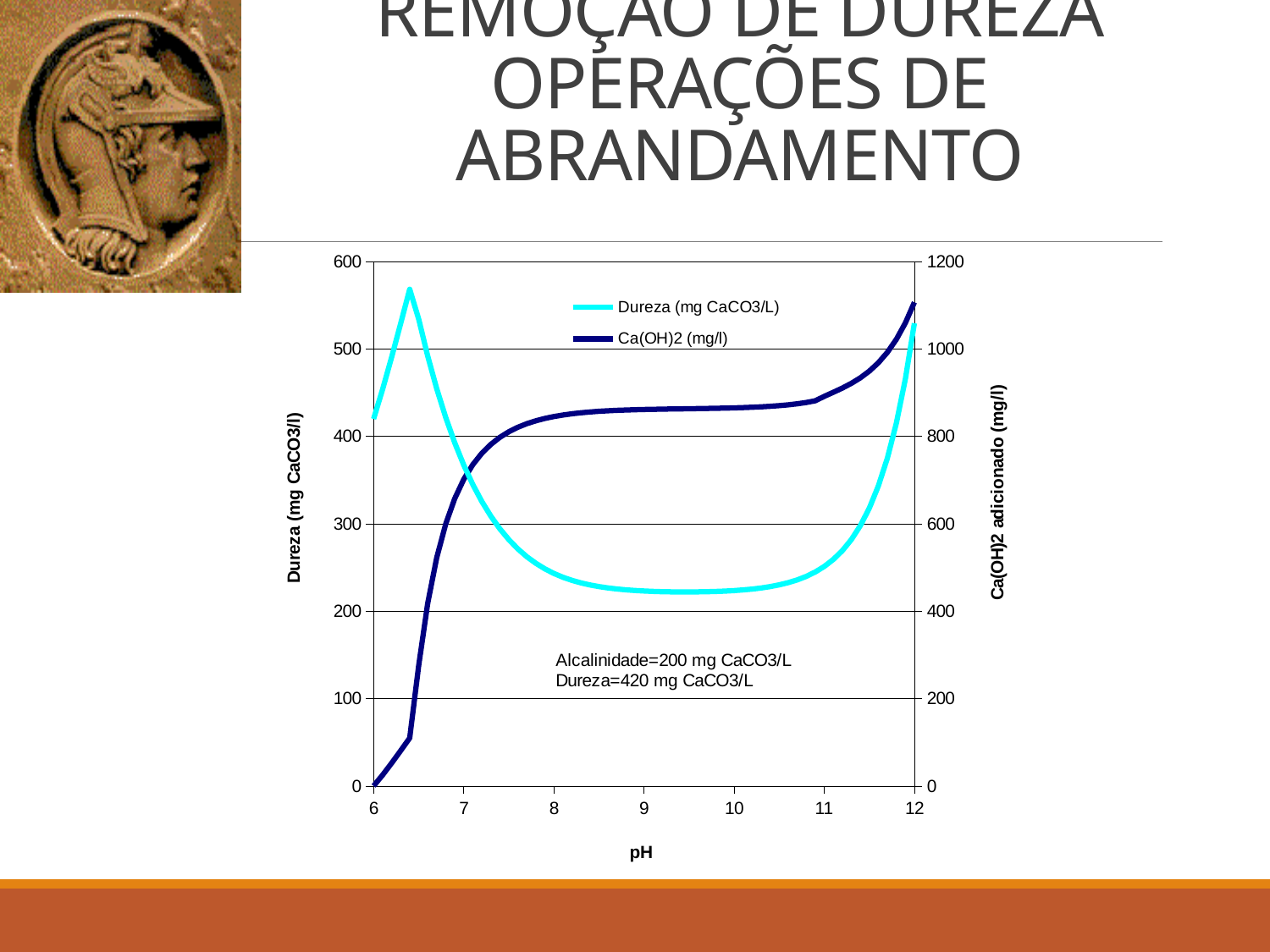
How many series does the chart legend list? 2 Does the Dureza series rise or fall as pH increases from 7 to 9? fall What is the title of the x axis of the chart? pH What is the highest value shown on the right-hand axis (Ca(OH)2 adicionado)? 1200 Is the Ca(OH)2 value at pH 7 greater or less than 600 on the right axis? greater Is the Ca(OH)2 value at pH 12 greater or less than 1000 on the right axis? greater Does the Ca(OH)2 series generally rise or fall as pH increases from 6 to 12? rise What are the two series named in the chart legend? Dureza (mg CaCO3/L) and Ca(OH)2 (mg/l) Is the peak Dureza value near pH 6.4 greater or less than 500? greater What kind of chart is shown on the slide? line chart